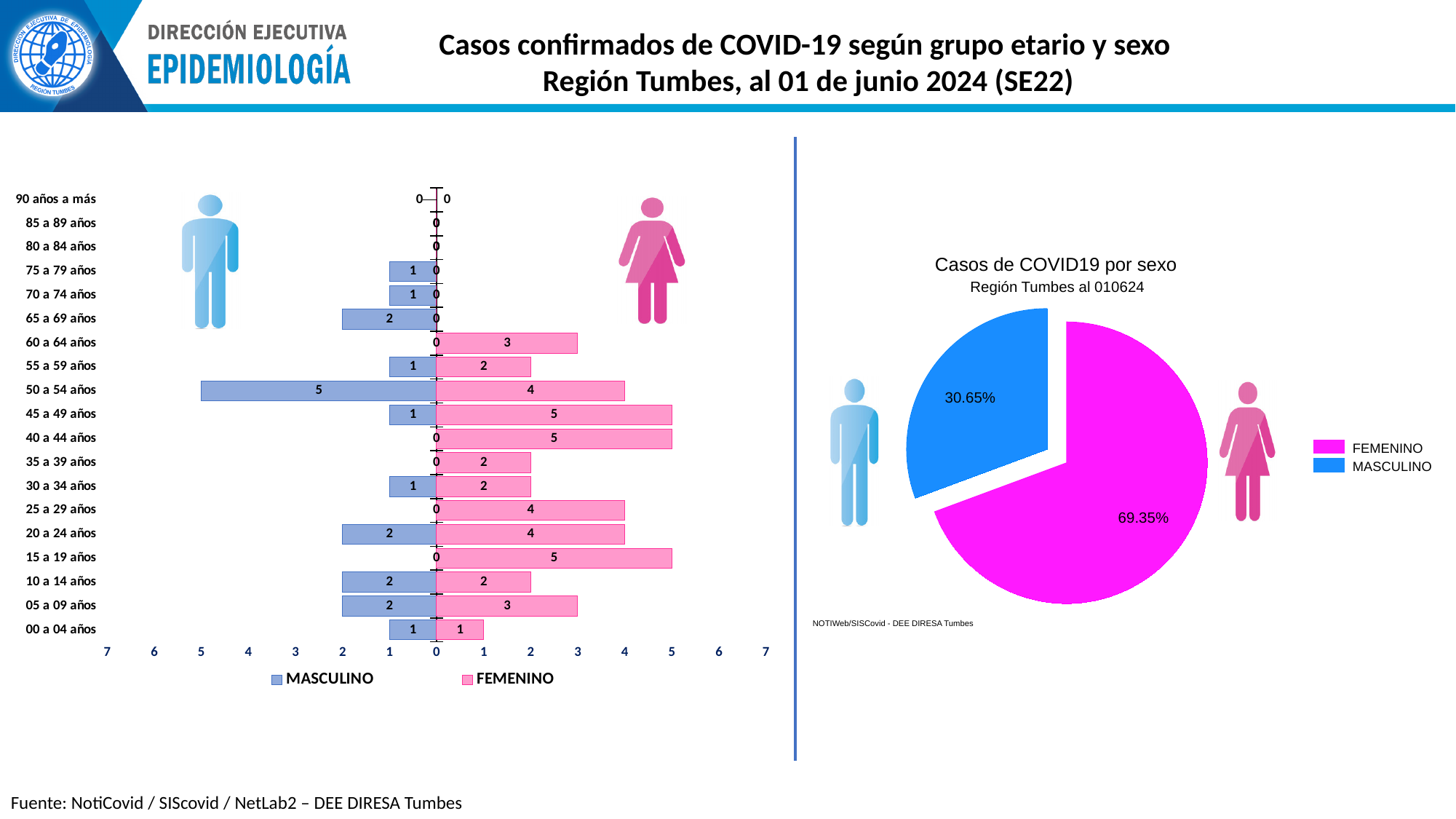
In the left bar chart, what is the MASCULINO value for the 50 a 54 años age group? 5 In the left bar chart, what is the FEMENINO value for the 20 a 24 años age group? 4 In the pie chart 'Casos de COVID19 por sexo', what share is MASCULINO? 30.65% In the left bar chart, what is the difference between the FEMENINO and MASCULINO values for the 45 a 49 años age group? 4 How many series does the legend of the left bar chart list? 2 How many age groups are shown in the left bar chart? 19 What kind of chart is the chart on the left of the slide? Bar chart In the left bar chart, what is the FEMENINO value for the 60 a 64 años age group? 3 In the left bar chart, which is larger for the 50 a 54 años age group, MASCULINO or FEMENINO? MASCULINO In the pie chart 'Casos de COVID19 por sexo', which slice is larger, FEMENINO or MASCULINO? FEMENINO In the left bar chart, which age group has the highest MASCULINO value? 50 a 54 años In the pie chart 'Casos de COVID19 por sexo', what share is FEMENINO? 69.35%